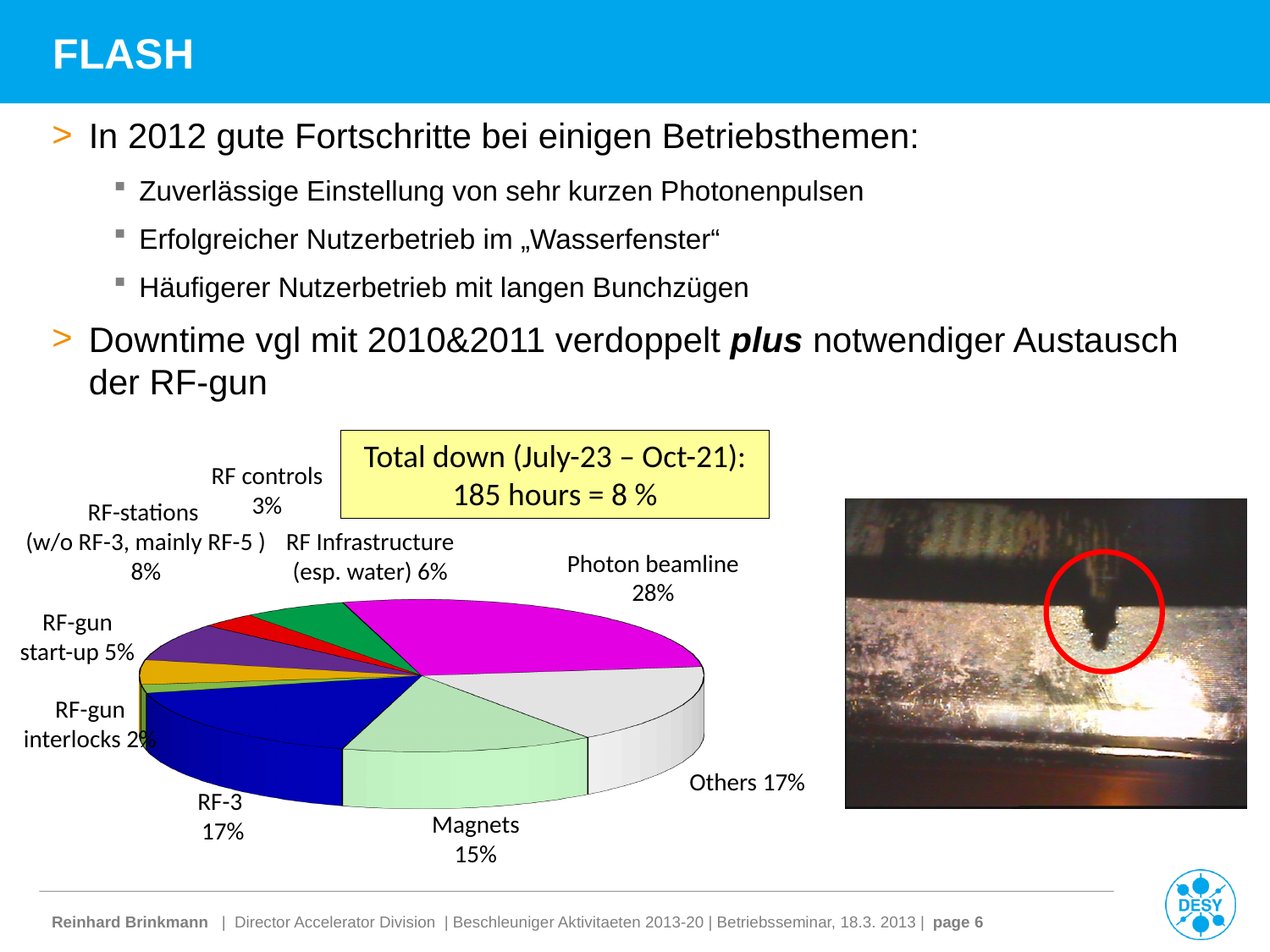
Which category has the largest slice of the pie? Photon beamline What share of the downtime is attributed to Photon beamline? 28% What percentage is shown for RF Infrastructure (esp. water)? 6% What percentage is shown for RF-stations (w/o RF-3, mainly RF-5)? 8% What kind of chart is shown on the slide? pie chart Which category has the smallest slice of the pie? RF-gun interlocks What is the difference in percentage points between Photon beamline and Others? 11 How many slices does the pie chart have? 9 Which is larger, the share for RF-gun start-up or the share for RF controls? RF-gun start-up What percentage is shown for RF-3? 17% What share of the downtime is attributed to Magnets? 15% What is the total downtime stated in the box above the pie chart? 185 hours = 8 %